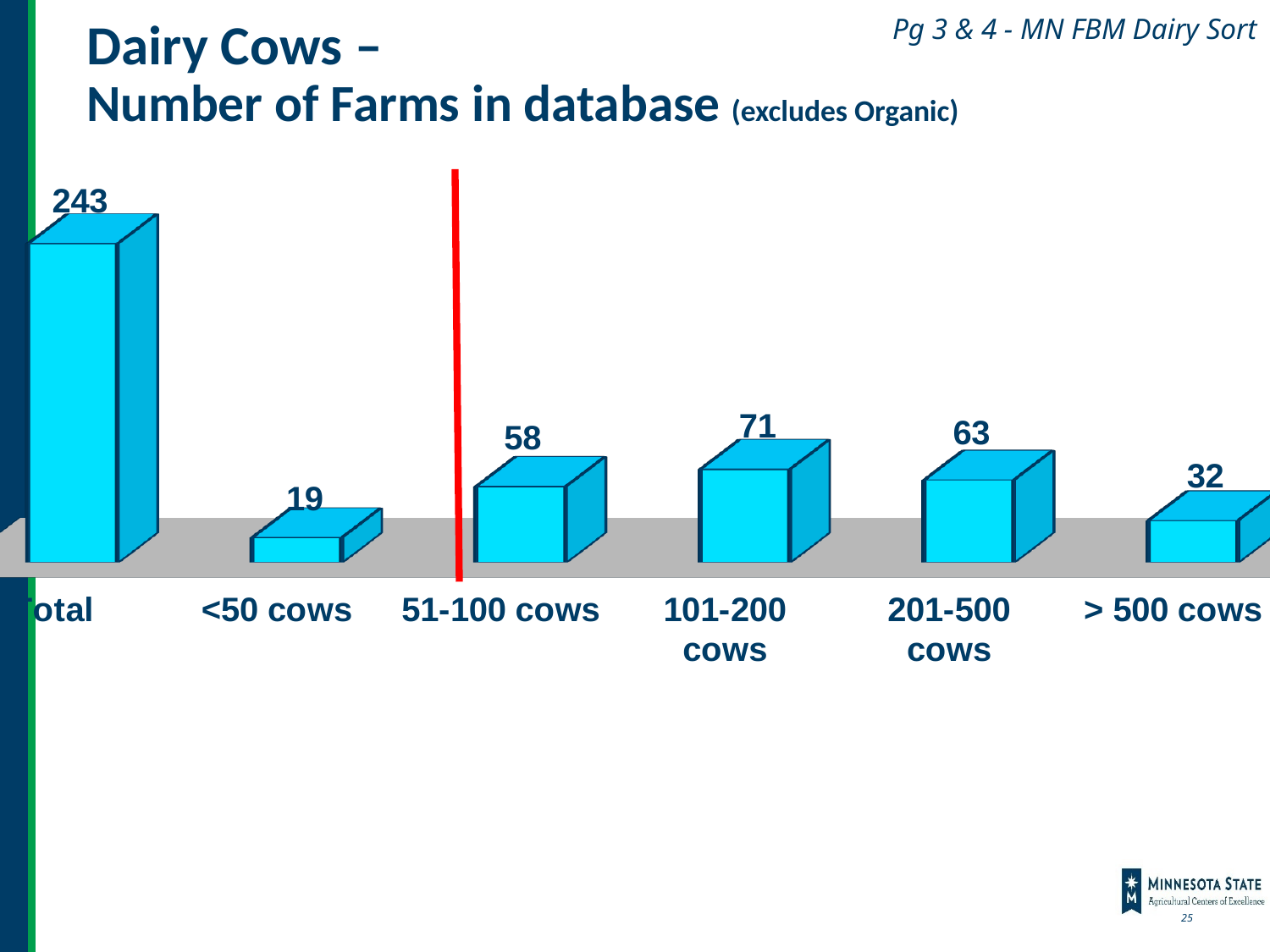
Which herd-size category has the lowest number of farms? <50 cows What is the number of farms for > 500 cows? 32 Which has more farms: 51-100 cows or > 500 cows? 51-100 cows How many farms are in the <50 cows category? 19 What is the number of farms for 51-100 cows? 58 How many bars are shown in the chart? 6 What type of chart is shown on the slide? Bar chart What is the value shown for the 101-200 cows category? 71 Excluding the Total bar, which herd-size category has the highest number of farms? 101-200 cows What is the value of the Total bar? 243 What is the difference between the number of farms with 101-200 cows and those with 201-500 cows? 8 How many farms are in the 201-500 cows category? 63